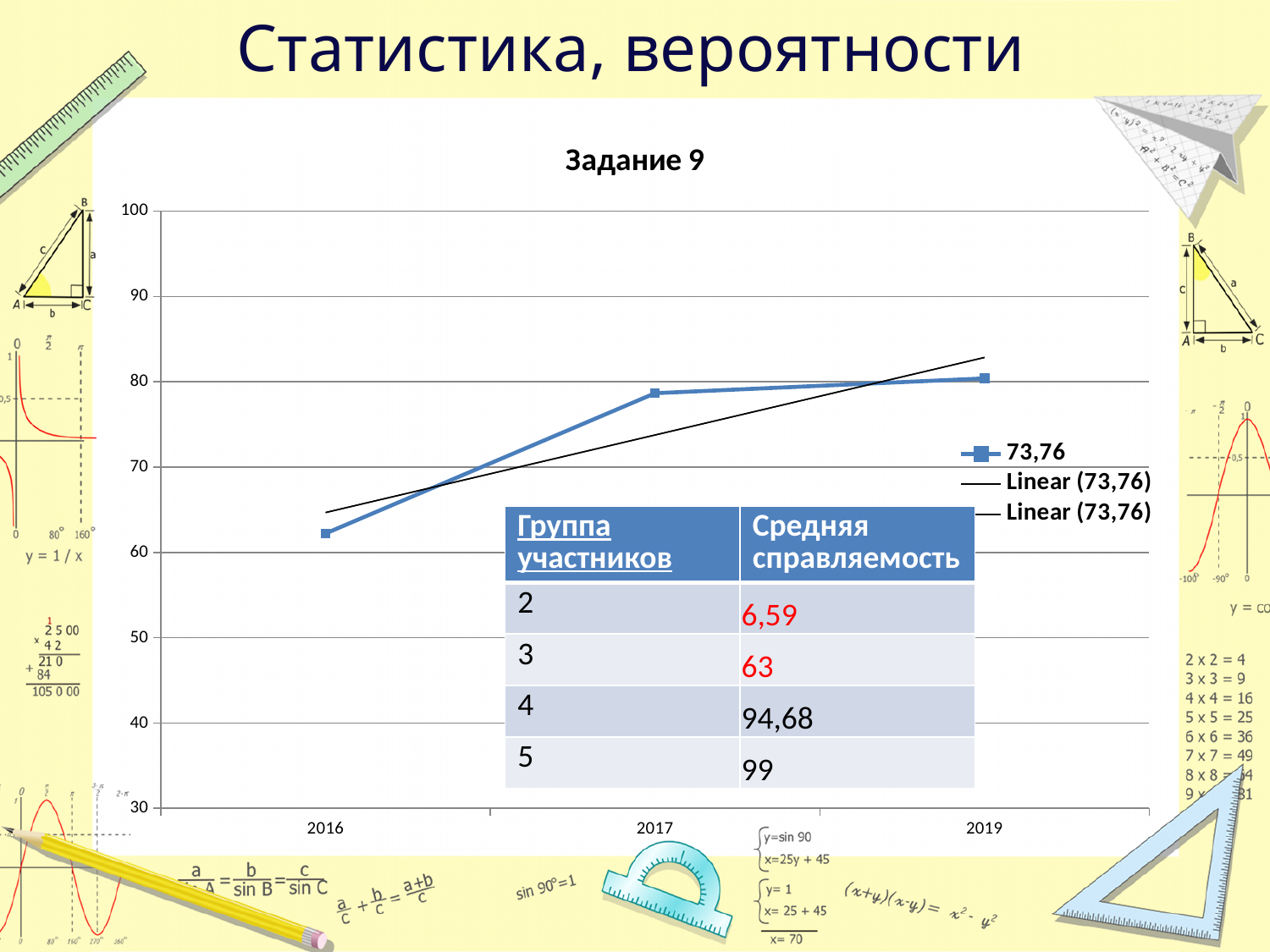
Is the value for 2016 greater or less than 70? less Is the value for 2017 greater or less than 90? less Is the value for 2017 greater or less than 70? greater How many entries does the chart legend list? 3 How many years are plotted along the x axis of the chart? 3 Do the values rise or fall from 2016 to 2019? rise What is the name of the data series shown with square markers in the legend? 73,76 What is the title of the chart? Задание 9 What kind of chart is shown under the title "Задание 9"? line chart Which year has the lowest value on the chart? 2016